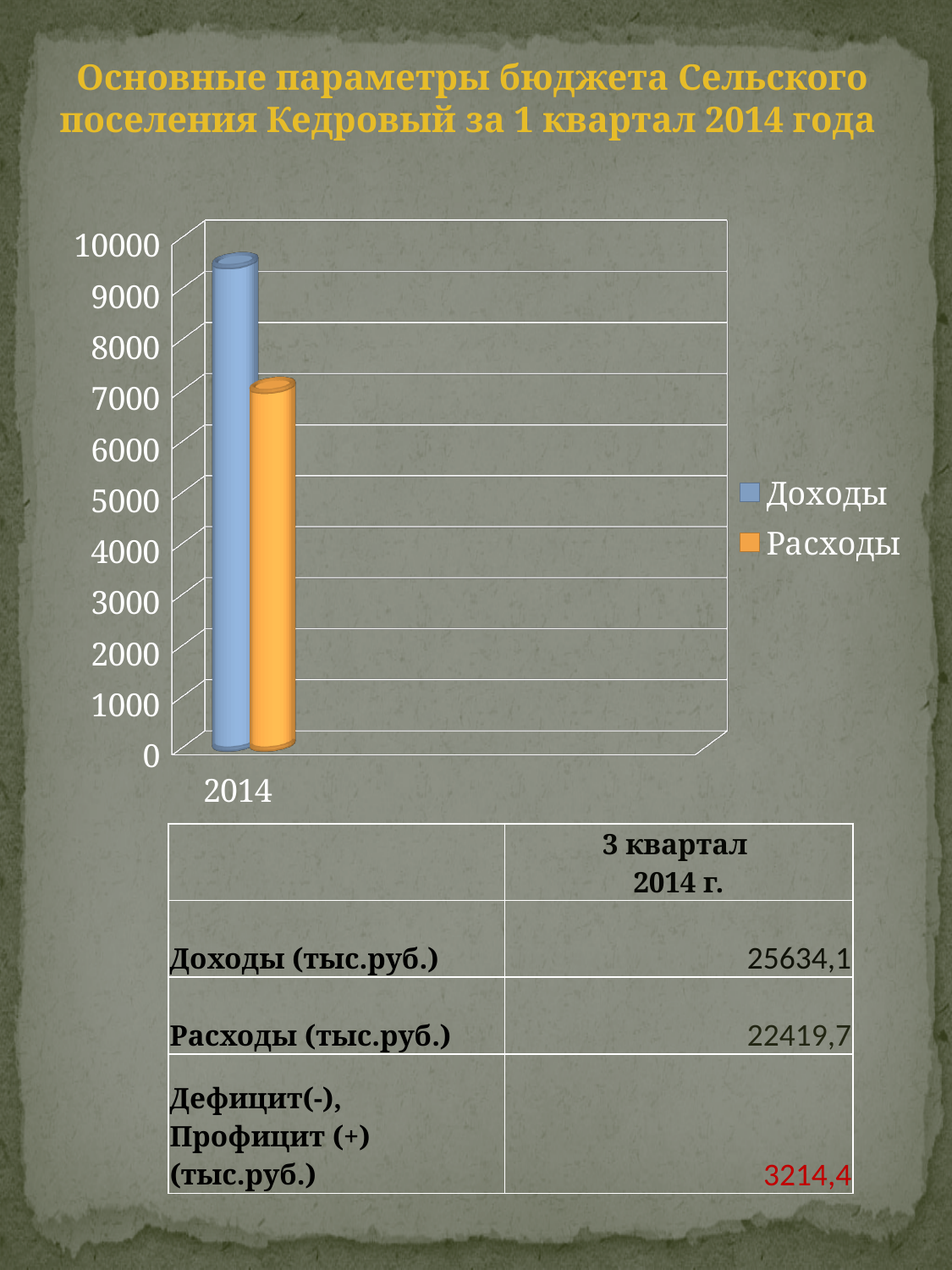
Is the value for Расходы in the chart greater or less than 6000? greater What is the category label shown on the x axis of the chart? 2014 Which series has the highest bar in the chart? Доходы Which series has the taller bar in the chart, Доходы or Расходы? Доходы Is the value for Расходы in the chart greater or less than 8000? less What colour is the bar for Расходы in the chart? orange How many categories are shown on the x axis of the chart? 1 Which series has the lowest bar in the chart? Расходы What kind of chart is shown on the slide? bar chart Is the value for Доходы in the chart greater or less than 9000? greater What is the highest value shown on the chart's vertical axis? 10000 How many series does the chart legend list? 2